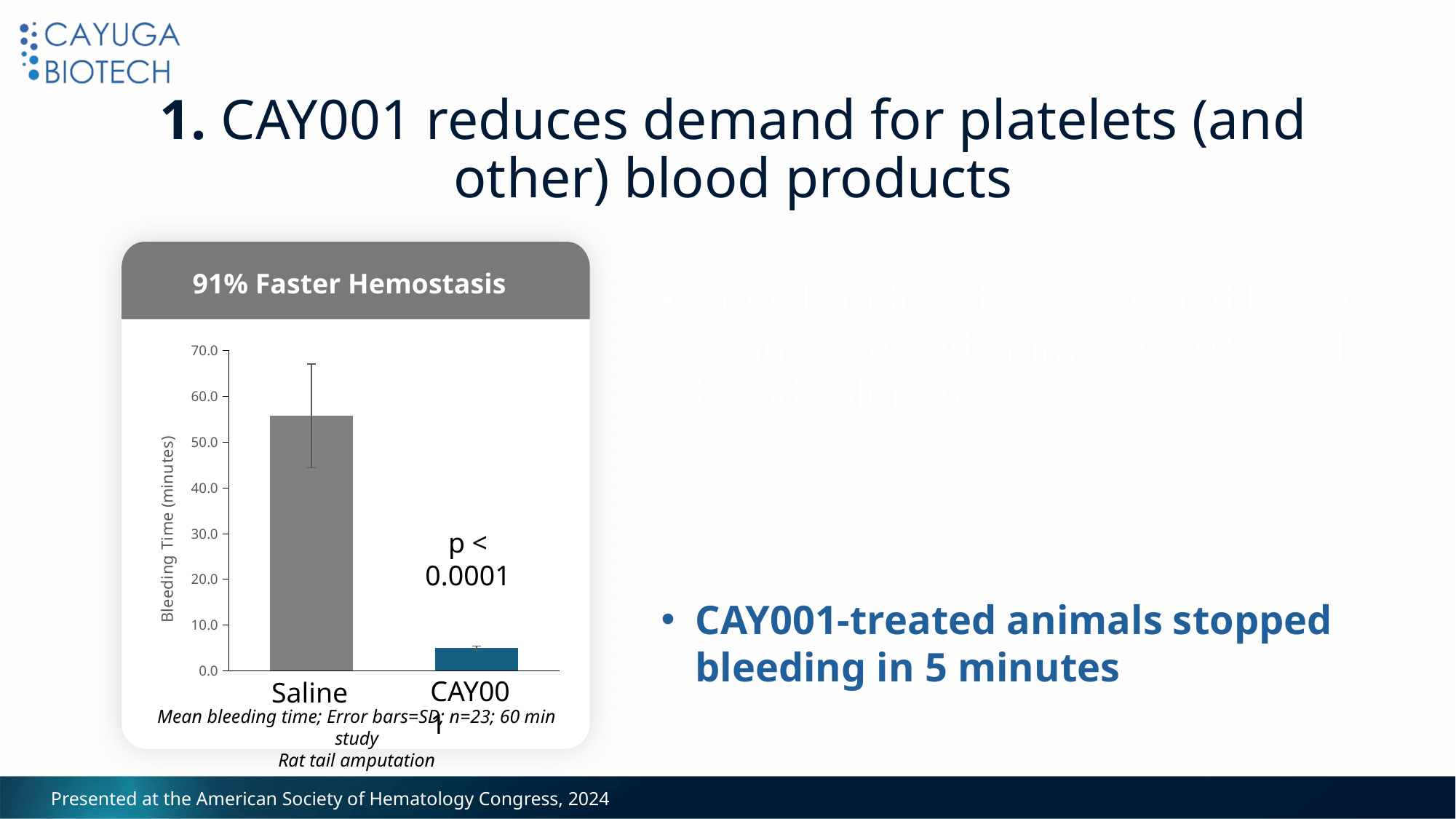
Does the bleeding time rise or fall from Saline to CAY001? Fall Is the bleeding time for CAY001 greater or less than 10.0 minutes? less How many categories are plotted in the chart? 2 Is the bleeding time for Saline greater or less than 50.0 minutes? greater What is the label of the chart's y axis? Bleeding Time (minutes) What is the title shown above the chart? 91% Faster Hemostasis Which category has the lowest bleeding time in the chart? CAY001 Which category has the highest bleeding time in the chart? Saline What kind of chart is shown on the slide? Bar chart Is the bleeding time for Saline greater or less than 60.0 minutes? less Which has a larger bleeding time, Saline or CAY001? Saline